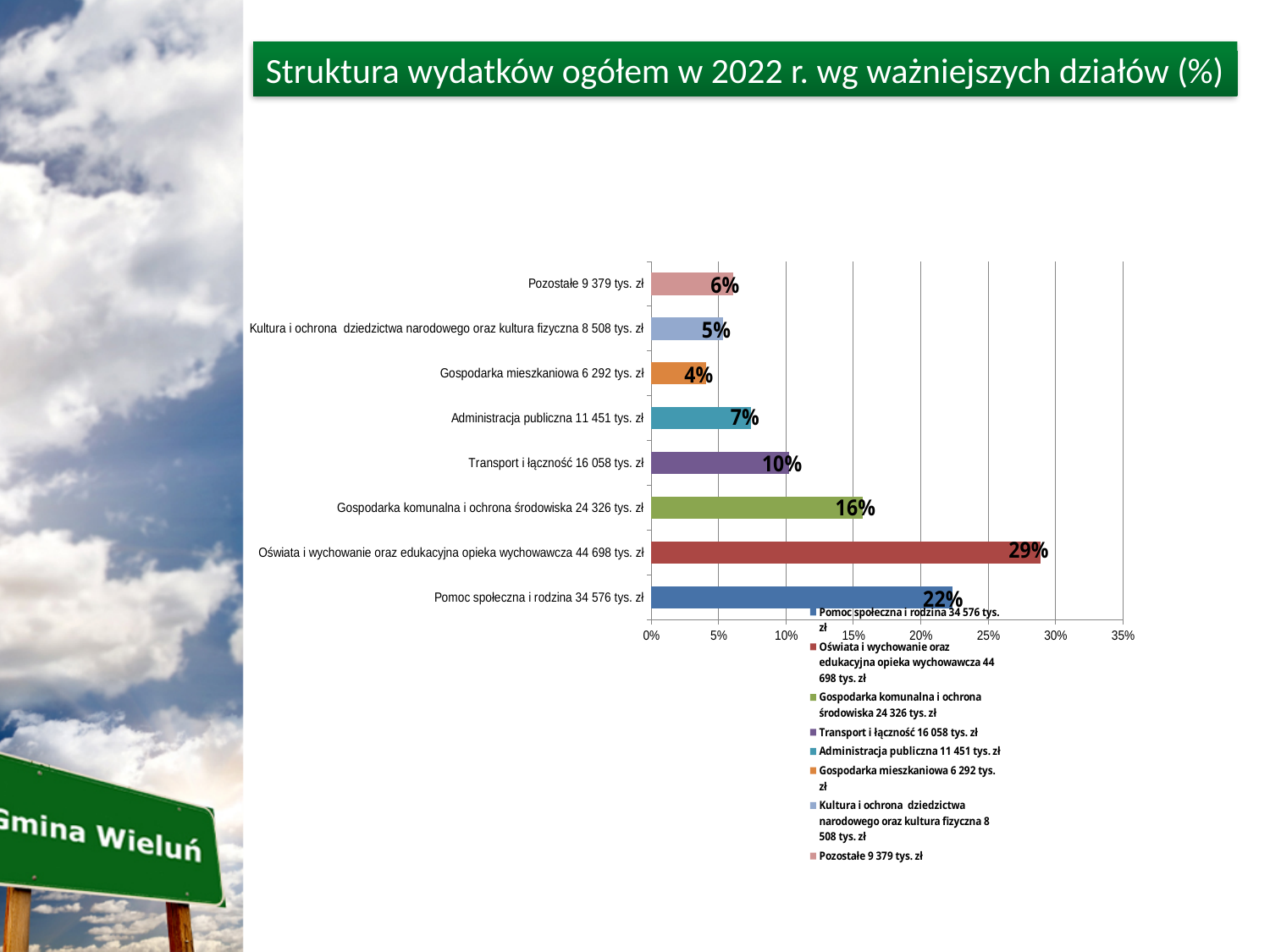
What is the value for Transport i łączność? 10% How many categories are shown in the chart? 8 What is the title of the slide? Struktura wydatków ogółem w 2022 r. wg ważniejszych działów (%) Which category has the lowest value? Gospodarka mieszkaniowa What is the value for Oświata i wychowanie oraz edukacyjna opieka wychowawcza? 29% What is the value for Gospodarka mieszkaniowa? 4% What is the difference between the values for Oświata i wychowanie oraz edukacyjna opieka wychowawcza and Pomoc społeczna i rodzina? 7% Which category has the highest value? Oświata i wychowanie oraz edukacyjna opieka wychowawcza Which is larger, the value for Gospodarka komunalna i ochrona środowiska or the value for Transport i łączność? Gospodarka komunalna i ochrona środowiska How many entries does the legend list? 8 Is the value for Pomoc społeczna i rodzina greater or less than 20%? greater What kind of chart is shown on the slide? bar chart